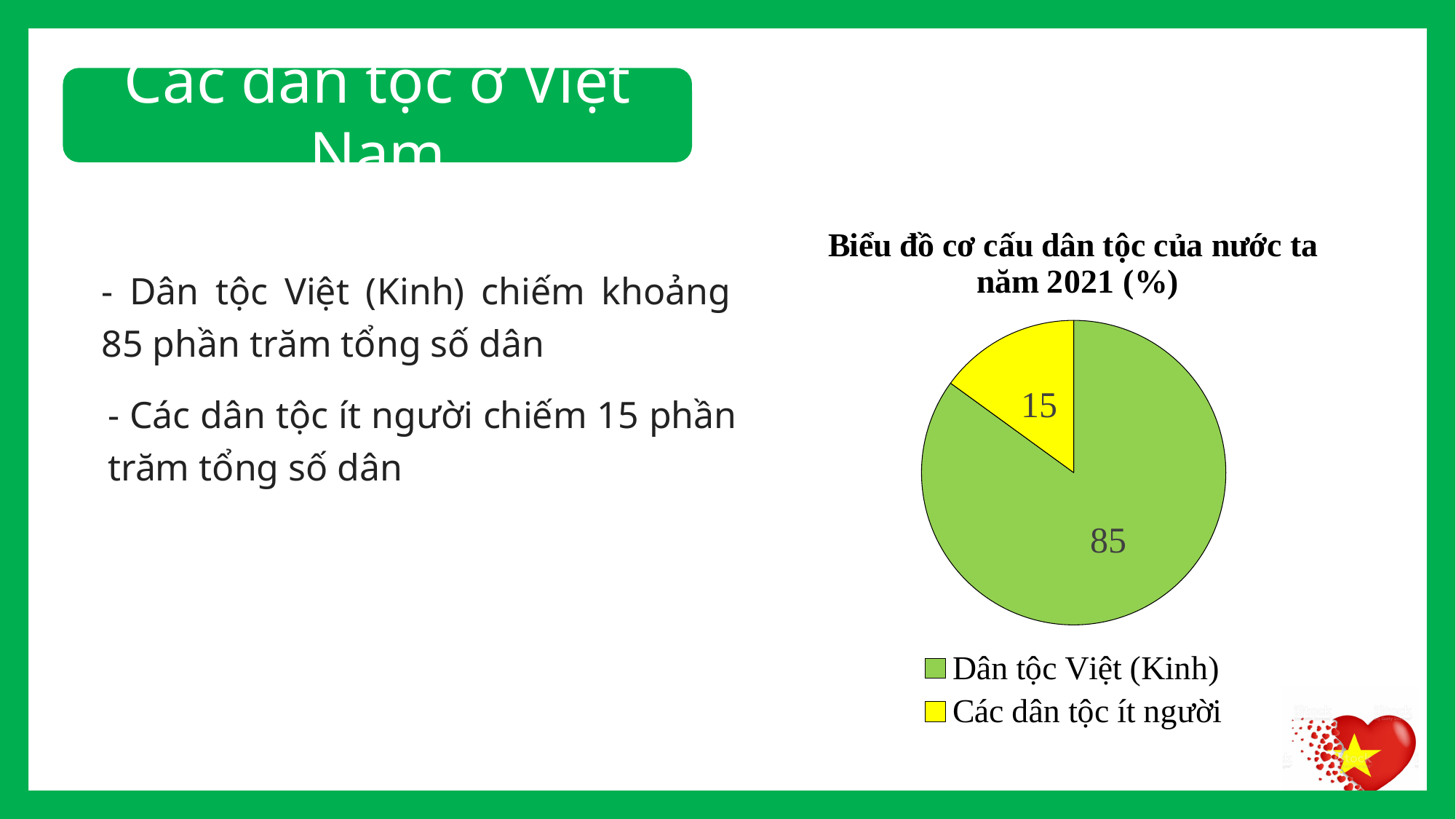
What is the difference between the values for Dân tộc Việt (Kinh) and Các dân tộc ít người? 70 Which is larger, the slice for Dân tộc Việt (Kinh) or the slice for Các dân tộc ít người? Dân tộc Việt (Kinh) What colour is the slice for Các dân tộc ít người? yellow How many entries does the legend list? 2 What share of the pie does Các dân tộc ít người represent? 15% What is the value for Dân tộc Việt (Kinh) in the pie chart? 85 How many slices does the pie chart have? 2 What kind of chart is shown on the slide? pie chart What is the title of the pie chart? Biểu đồ cơ cấu dân tộc của nước ta năm 2021 (%) Which category has the largest slice in the pie chart? Dân tộc Việt (Kinh) Which category has the smallest slice in the pie chart? Các dân tộc ít người What is the value for Các dân tộc ít người in the pie chart? 15